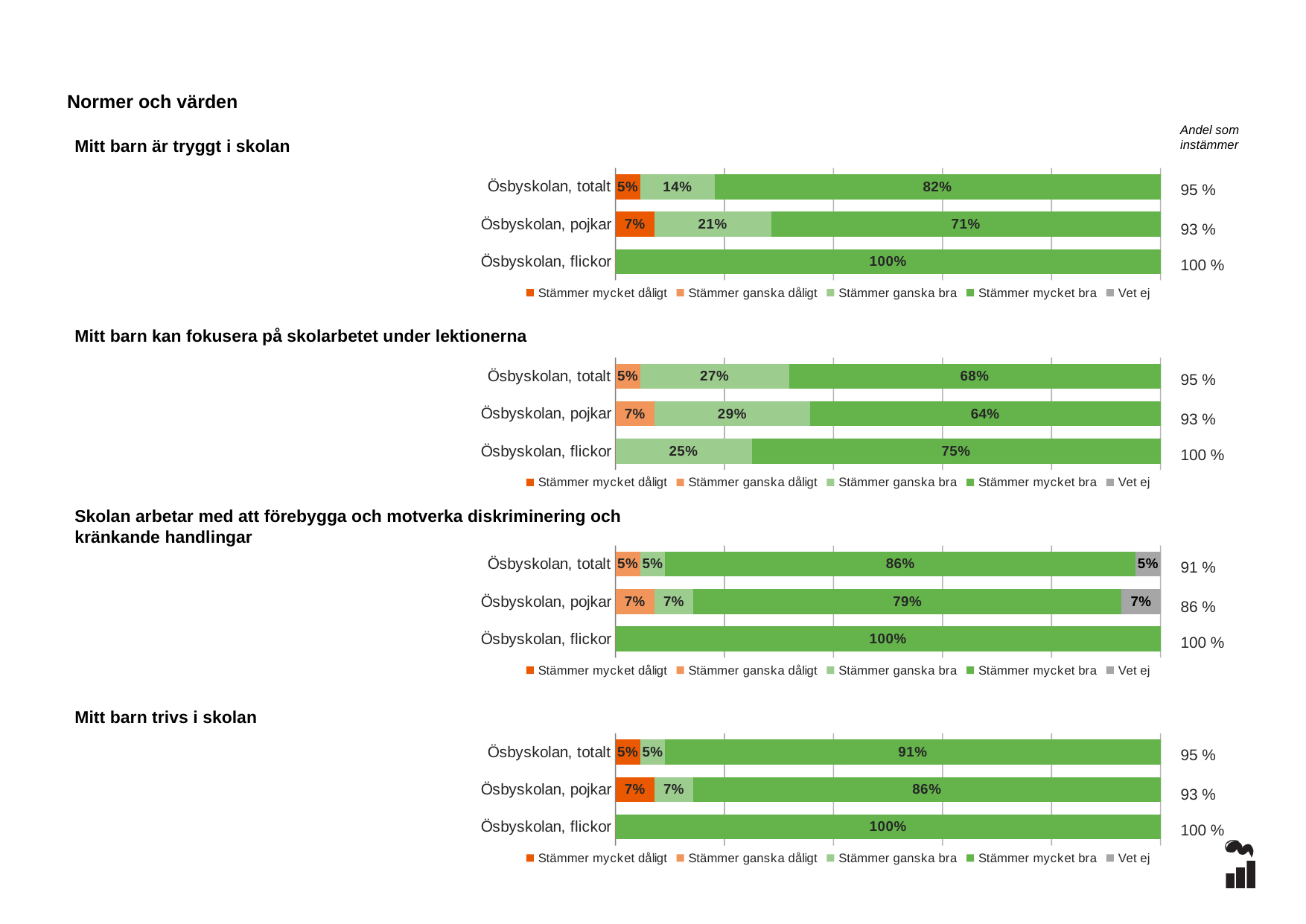
How many series does the legend of the chart 'Mitt barn trivs i skolan' list? 5 In the chart 'Mitt barn kan fokusera på skolarbetet under lektionerna', which category has the lowest 'Stämmer mycket bra' value? Ösbyskolan, pojkar What kind of chart is 'Mitt barn är tryggt i skolan'? Stacked bar chart How many categories are shown in the chart 'Mitt barn kan fokusera på skolarbetet under lektionerna'? 3 In the chart 'Mitt barn trivs i skolan', which category has the highest 'Stämmer mycket bra' value? Ösbyskolan, flickor In the chart 'Mitt barn kan fokusera på skolarbetet under lektionerna', what is the 'Stämmer mycket bra' value for Ösbyskolan, flickor? 75% In the chart 'Mitt barn är tryggt i skolan', what is the difference between the 'Stämmer mycket bra' values for Ösbyskolan, flickor and Ösbyskolan, pojkar? 29% In the chart 'Skolan arbetar med att förebygga och motverka diskriminering och kränkande handlingar', what is the 'Vet ej' value for Ösbyskolan, pojkar? 7% In the chart 'Mitt barn är tryggt i skolan', what is the 'Stämmer ganska bra' value for Ösbyskolan, pojkar? 21% In the chart 'Mitt barn är tryggt i skolan', what is the 'Stämmer mycket bra' value for Ösbyskolan, totalt? 82% In the chart 'Skolan arbetar med att förebygga och motverka diskriminering och kränkande handlingar', what is the difference between the 'Stämmer mycket bra' values for Ösbyskolan, totalt and Ösbyskolan, pojkar? 7% In the chart 'Mitt barn trivs i skolan', is the 'Stämmer mycket bra' value larger for Ösbyskolan, totalt or Ösbyskolan, pojkar? Ösbyskolan, totalt